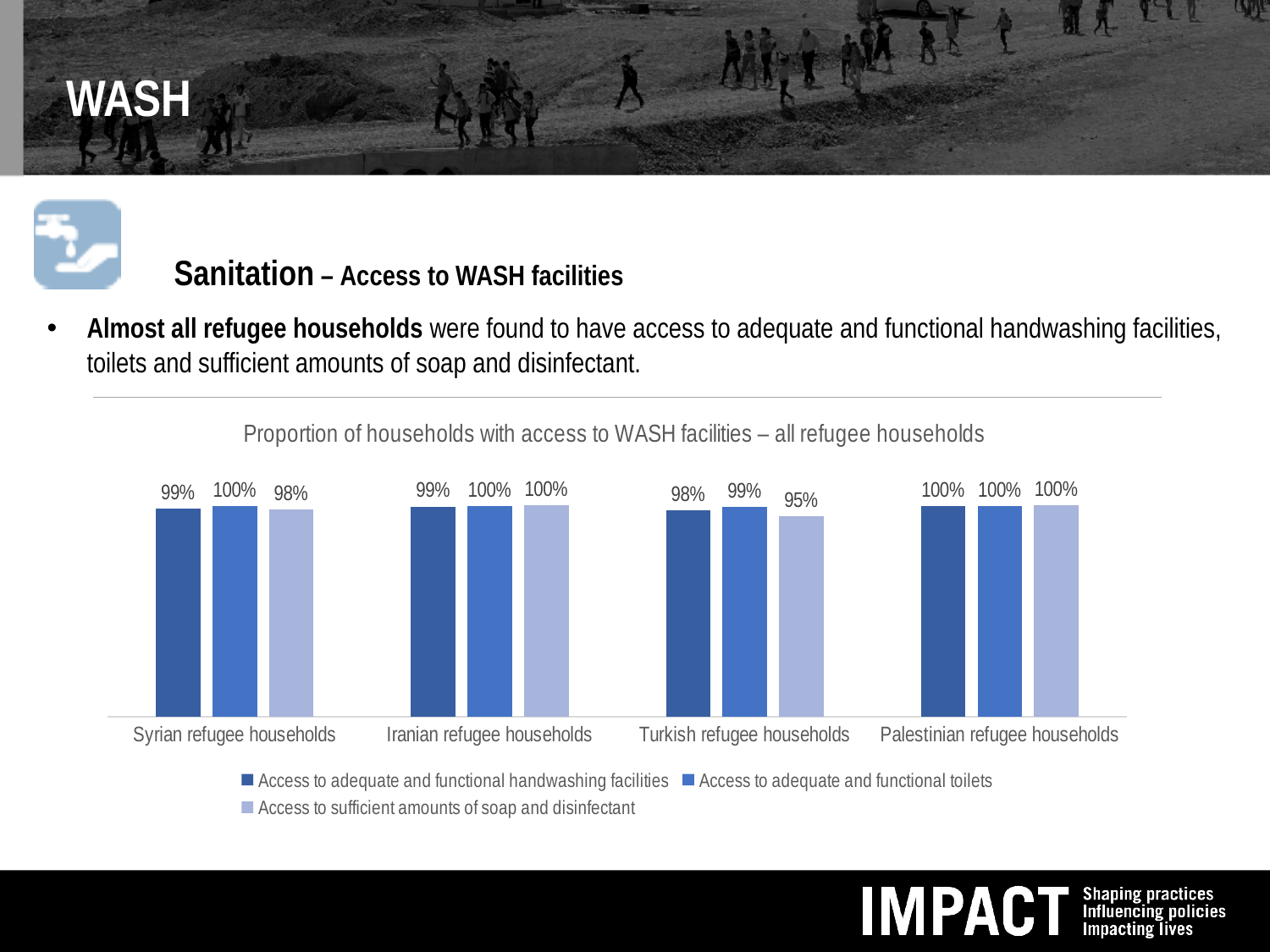
Which is larger for Syrian refugee households: access to adequate and functional toilets or access to sufficient amounts of soap and disinfectant? Access to adequate and functional toilets What is the difference between the access to adequate and functional toilets value and the access to sufficient amounts of soap and disinfectant value for Turkish refugee households? 4% How many series does the chart's legend list? 3 What is the value for access to adequate and functional handwashing facilities among Syrian refugee households? 99% What is the value for access to sufficient amounts of soap and disinfectant among Syrian refugee households? 98% Which household group has the lowest value for access to sufficient amounts of soap and disinfectant? Turkish refugee households What is the value for access to adequate and functional toilets among Iranian refugee households? 100% Which household group has all three values at 100%? Palestinian refugee households What is the value for access to sufficient amounts of soap and disinfectant among Turkish refugee households? 95% How many household groups are shown on the x axis of the chart? 4 What is the title of the chart? Proportion of households with access to WASH facilities – all refugee households What kind of chart is shown on the slide? Bar chart